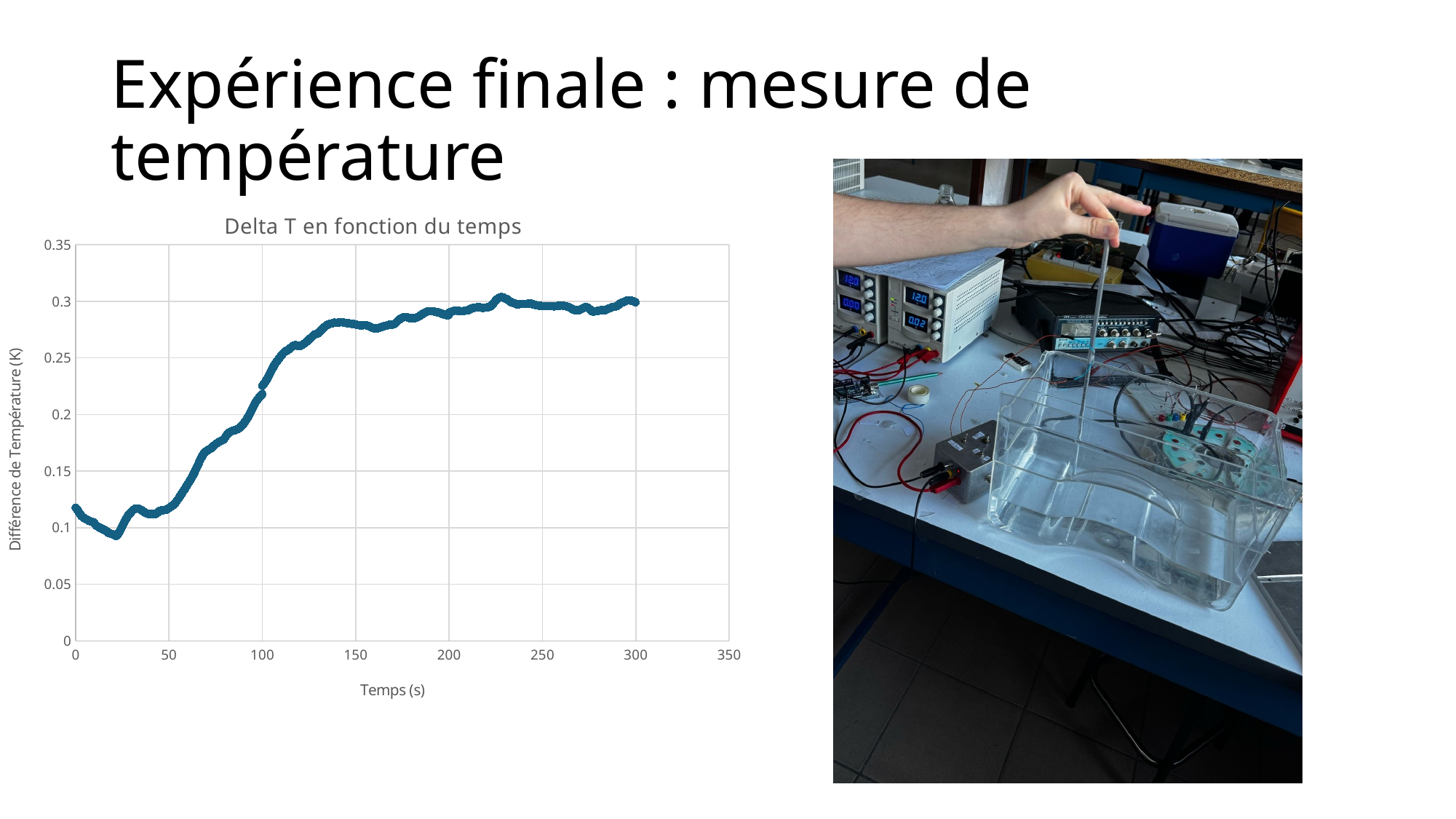
Is the value at 300 s greater or less than 0.25? greater What is the title of the chart? Delta T en fonction du temps Which is larger, the value at 50 s or the value at 200 s? the value at 200 s Which is larger, the value at 0 s or the value at 100 s? the value at 100 s Is the value at 0 s greater or less than 0.15? less Is the value at 100 s greater or less than 0.2? greater What is the highest tick value shown on the y axis? 0.35 What kind of chart is shown on the slide? scatter chart Overall, do the values rise or fall as time increases along the x axis? rise What is the label of the x axis of the chart? Temps (s)